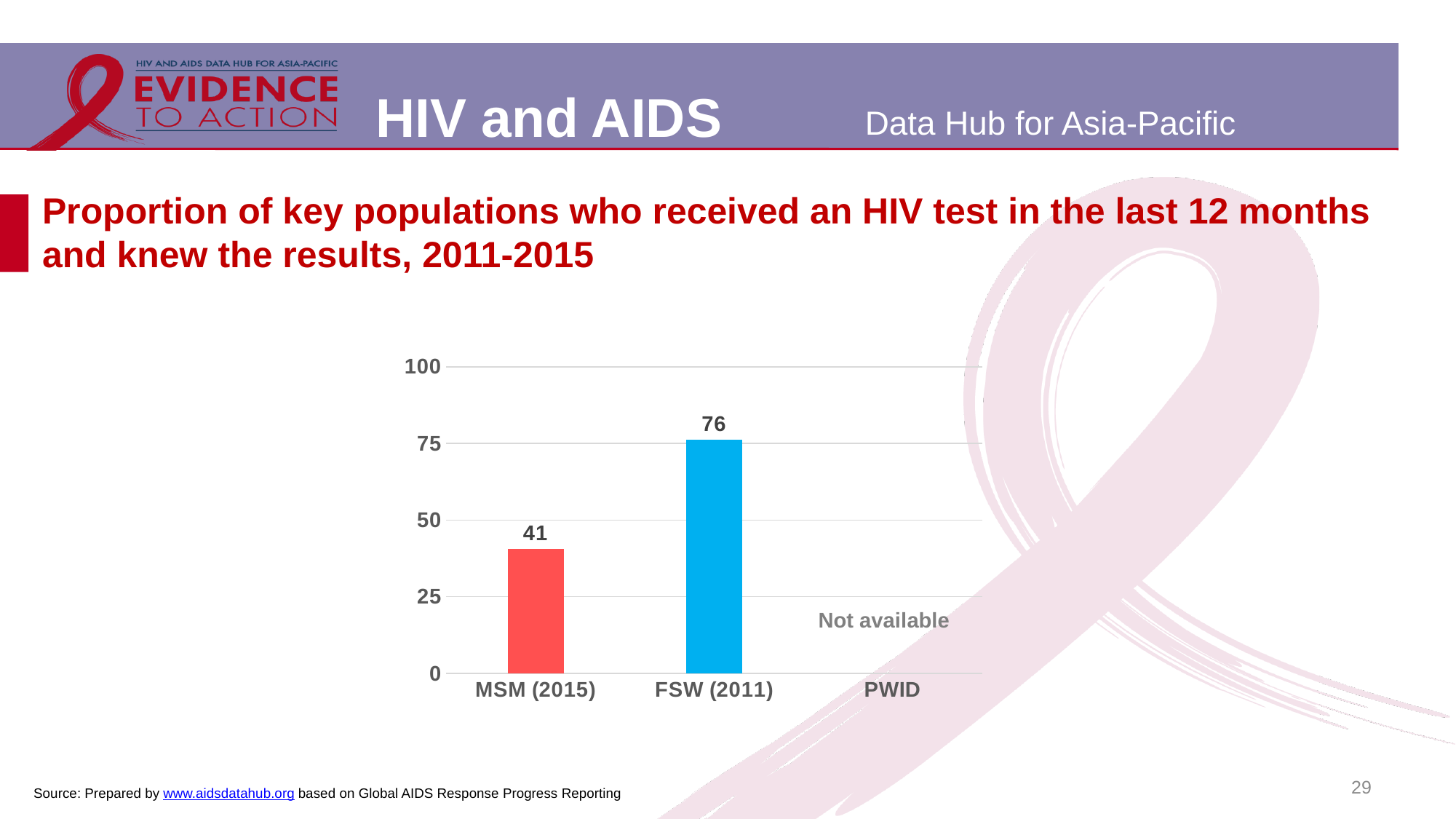
What is shown for PWID in the chart? Not available What colour is the bar for FSW (2011)? blue What is the maximum value shown on the y axis? 100 What is the value for MSM (2015)? 41 What is the value for FSW (2011)? 76 Which category has the highest value? FSW (2011) How many categories are shown on the x axis? 3 Is the value for FSW (2011) greater or less than 75? greater What kind of chart is shown on the slide? bar chart What is the difference between the values for FSW (2011) and MSM (2015)? 35 Is the value for MSM (2015) greater or less than 50? less Which is larger, the value for MSM (2015) or FSW (2011)? FSW (2011)